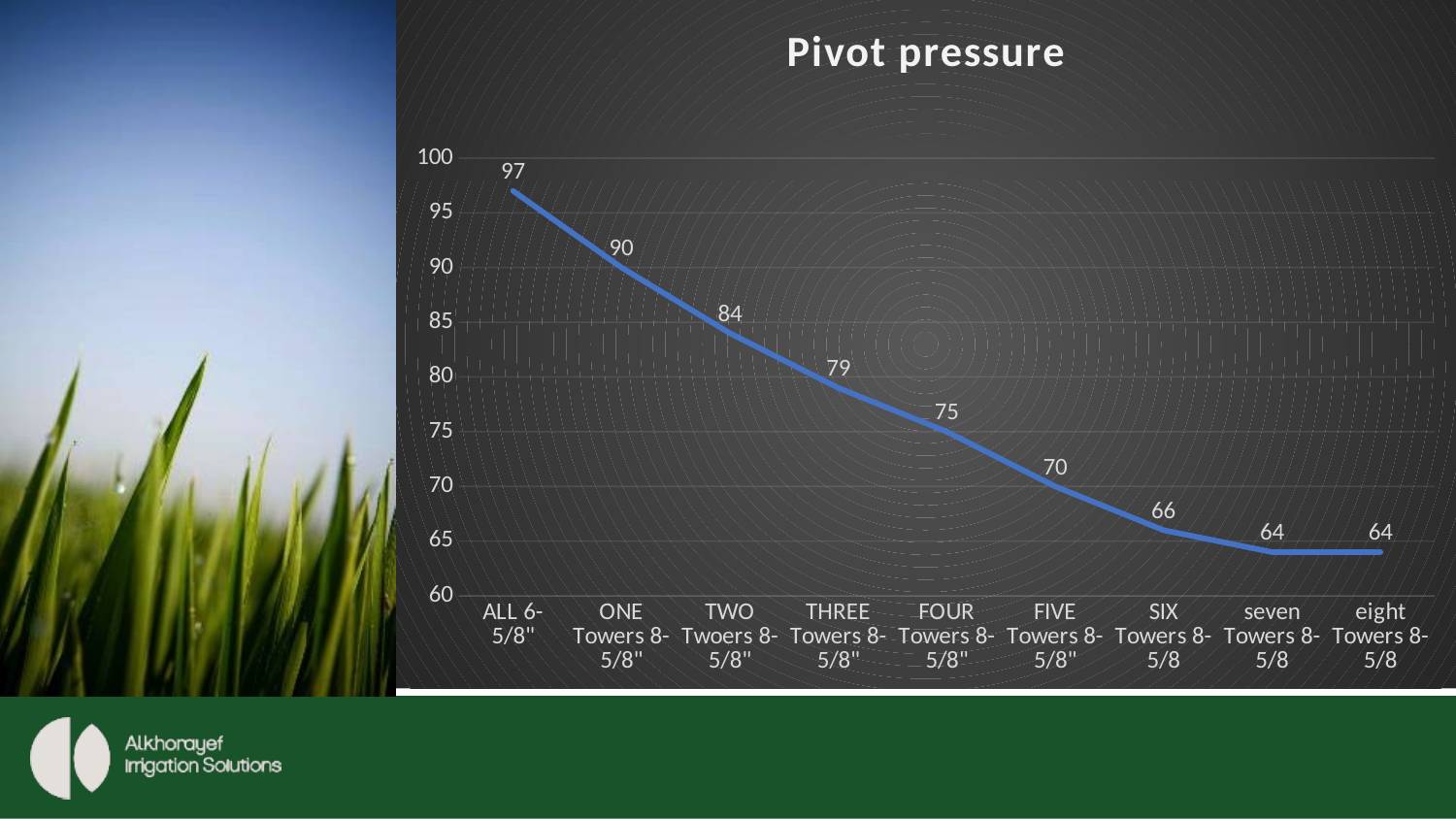
What is the pivot pressure value for THREE Towers 8-5/8"? 79 What is the title of the chart? Pivot pressure What is the lowest value plotted on the chart? 64 Is the value for seven Towers 8-5/8 greater or less than 65? less What is the pivot pressure value for SIX Towers 8-5/8? 66 How many categories are plotted along the x axis? 9 Which is larger, the value for TWO Twoers 8-5/8" or the value for FOUR Towers 8-5/8"? TWO Twoers 8-5/8" What is the difference between the values for ONE Towers 8-5/8" and FIVE Towers 8-5/8"? 20 What is the pivot pressure value for ALL 6-5/8"? 97 What kind of chart is shown on the slide? line chart Do the values rise or fall from left to right along the x axis? fall Which category has the highest pivot pressure value? ALL 6-5/8"